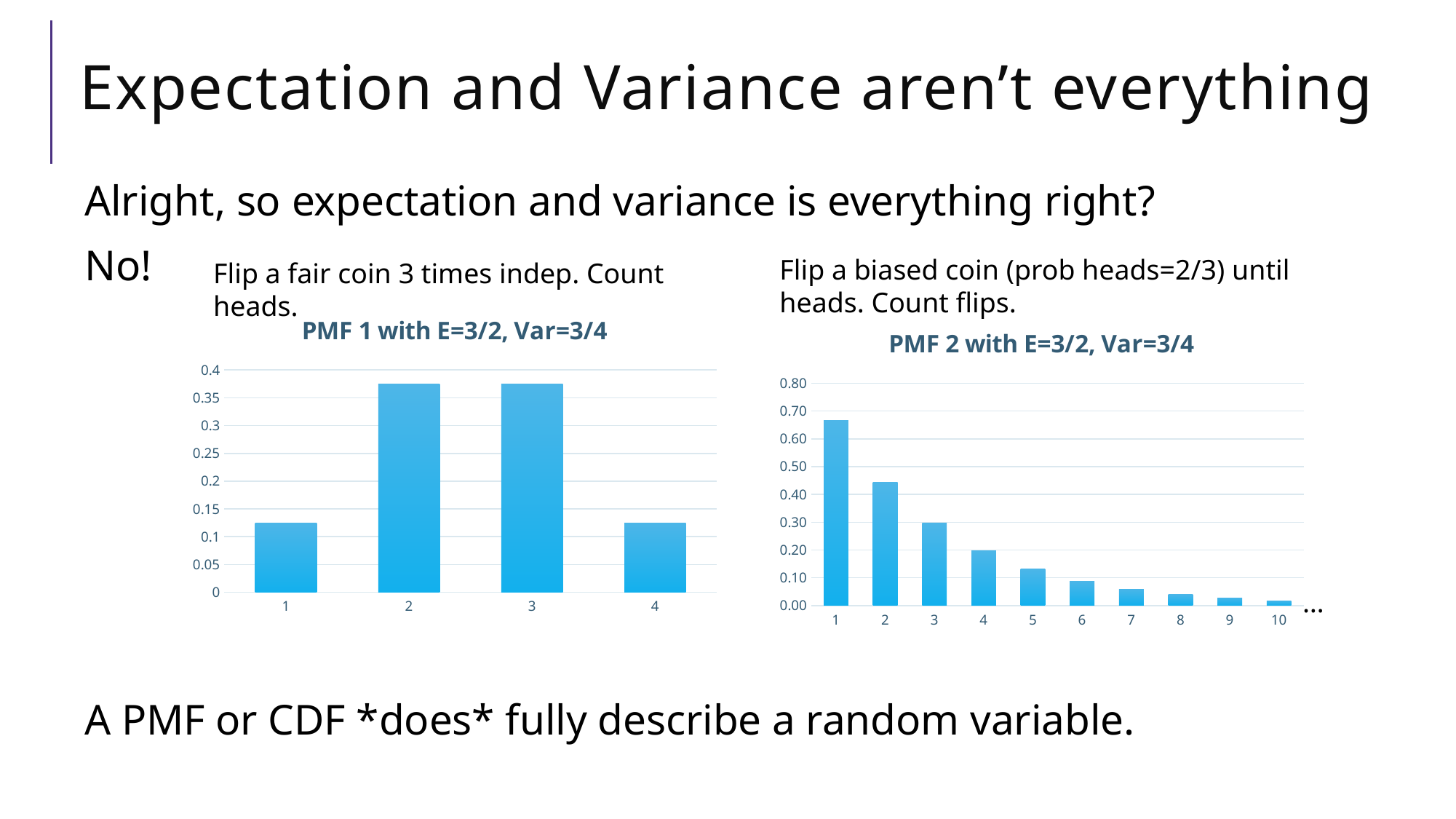
In the chart titled 'PMF 1 with E=3/2, Var=3/4', is the value for category 2 greater or less than 0.3? greater In the chart titled 'PMF 1 with E=3/2, Var=3/4', which is larger, the value for category 2 or the value for category 1? category 2 In the chart titled 'PMF 2 with E=3/2, Var=3/4', is the value for category 1 greater or less than 0.60? greater In the chart titled 'PMF 2 with E=3/2, Var=3/4', which category has the highest value? 1 What kind of chart is the chart titled 'PMF 1 with E=3/2, Var=3/4'? bar chart In the chart titled 'PMF 2 with E=3/2, Var=3/4', do the values rise or fall as the category number increases? fall In the chart titled 'PMF 2 with E=3/2, Var=3/4', which category has the lowest value? 10 In the chart titled 'PMF 2 with E=3/2, Var=3/4', is the value for category 5 greater or less than 0.20? less What kind of chart is the chart titled 'PMF 2 with E=3/2, Var=3/4'? bar chart In the chart titled 'PMF 1 with E=3/2, Var=3/4', how many categories are shown on the x axis? 4 In the chart titled 'PMF 2 with E=3/2, Var=3/4', how many bars are plotted? 10